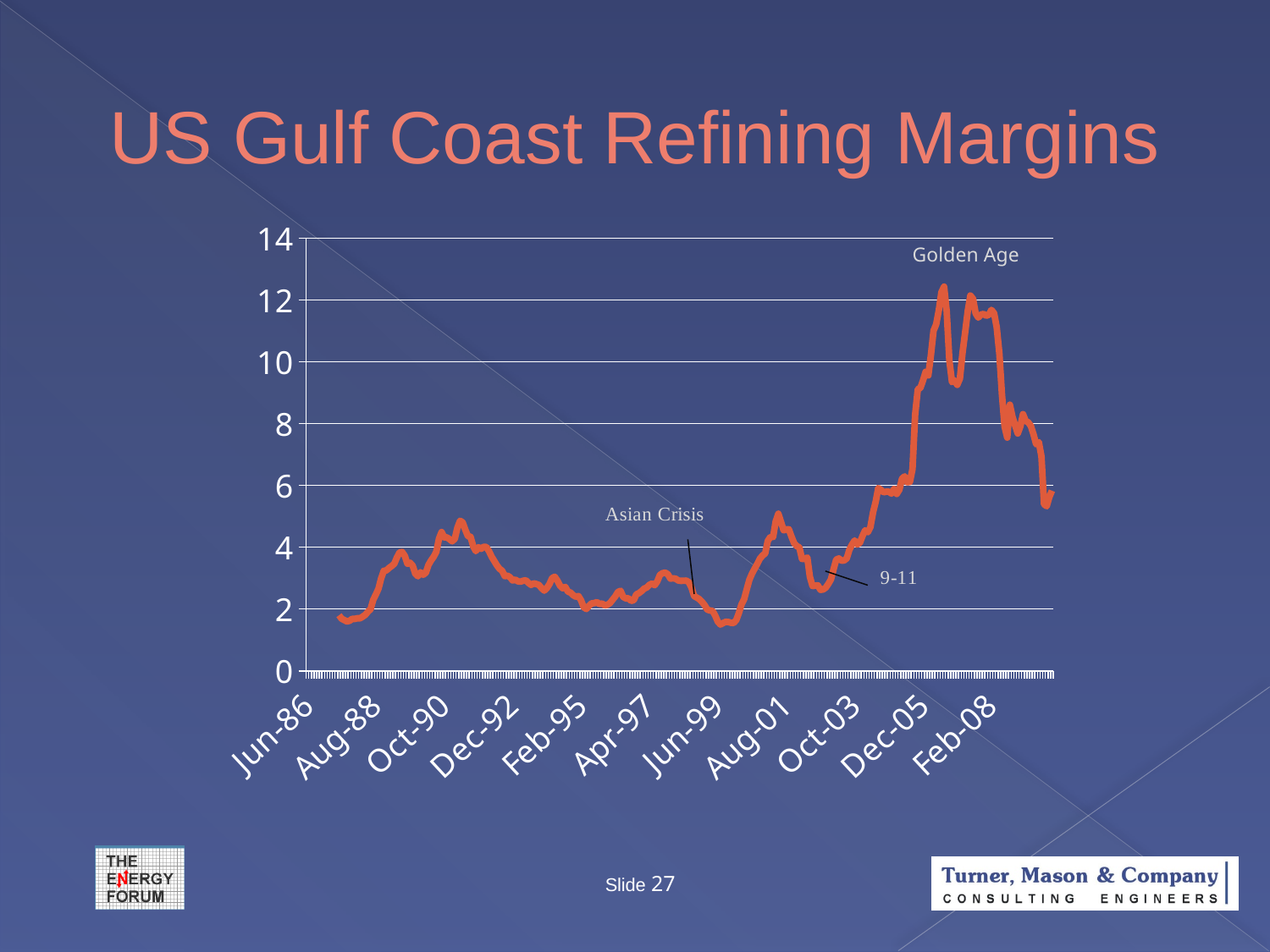
Do the values generally rise or fall between Oct-90 and Feb-95? fall What is the title of the chart? US Gulf Coast Refining Margins How many date labels are shown on the x axis? 11 Is the value around Jun-99 greater or less than 4? less What is the highest value shown on the y axis? 14 Do the values generally rise or fall between Oct-03 and Dec-05? rise Is the value around Oct-90 greater or less than 2? greater Is the highest value reached by the line greater or less than 12? greater What kind of chart is shown on the slide? line chart Which annotation labels the high-margin period near the right of the chart? Golden Age